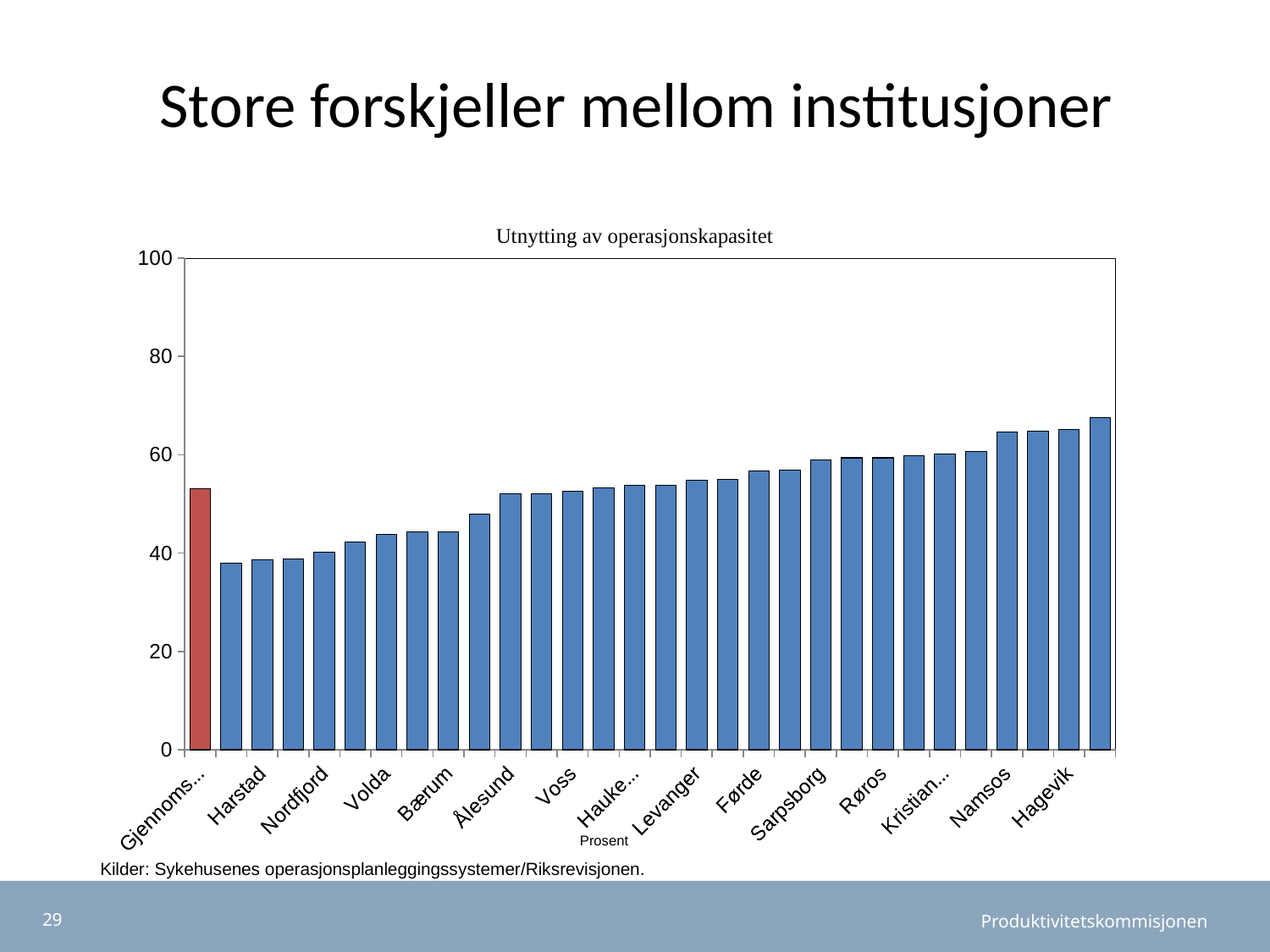
Is the value for Ålesund greater or less than 60? less Is the value for Harstad greater or less than 40? less Which bar is coloured differently (red) from the others? Gjennoms... Is the value for Gjennoms... greater or less than 40? greater What kind of chart is shown on the slide? bar chart Which has the larger value, Gjennoms... or Harstad? Gjennoms... Do the blue bars rise or fall from left to right along the x axis? rise Which has the larger value, Hagevik or Harstad? Hagevik What is the title of the chart? Utnytting av operasjonskapasitet